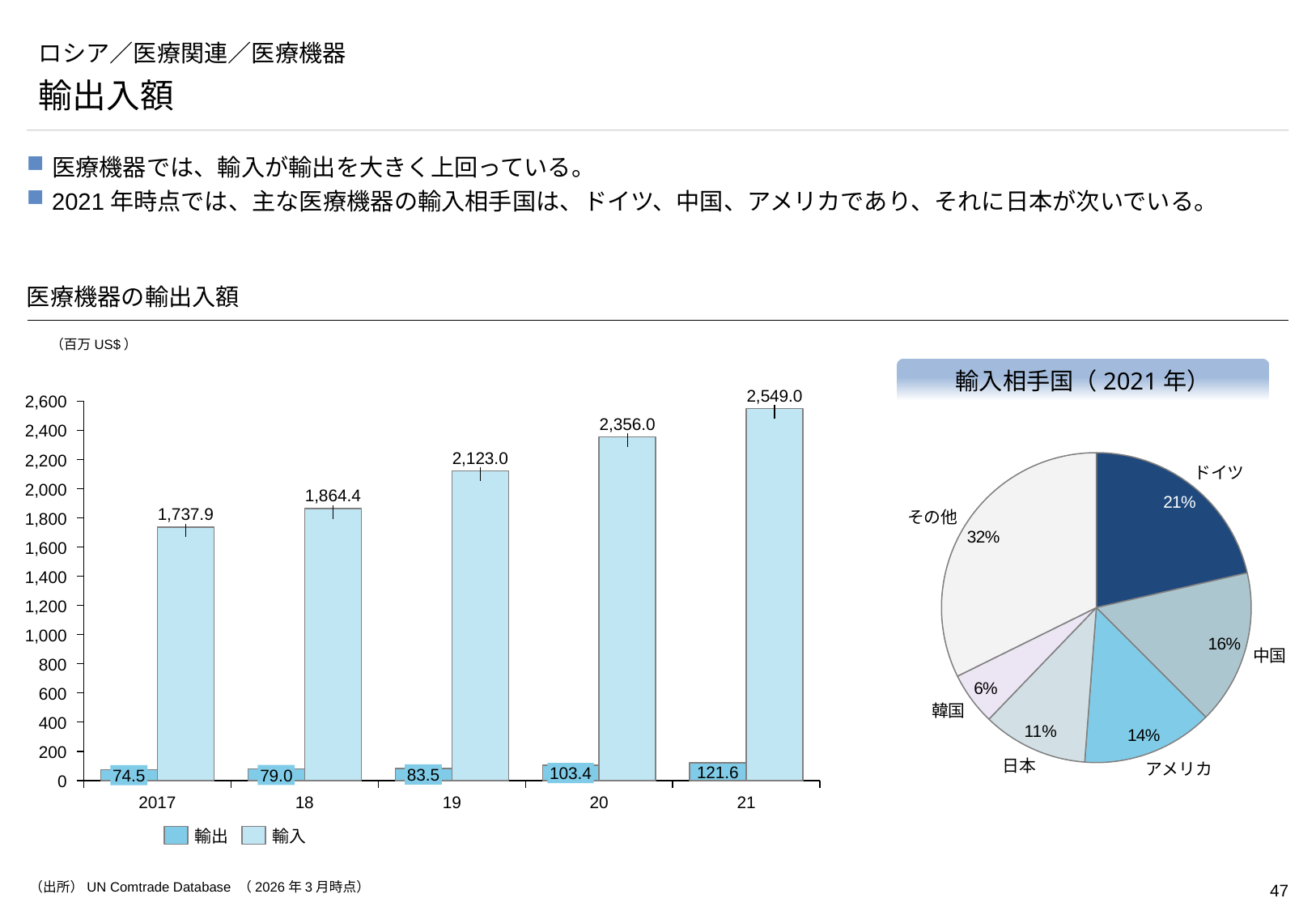
In the pie chart 輸入相手国（2021年）, which is larger, the share of 中国 or the share of アメリカ? 中国 In the bar chart 医療機器の輸出入額, how many years are shown on the x axis? 5 In the bar chart 医療機器の輸出入額, what is the 輸入 value for 2019? 2,123.0 In the pie chart 輸入相手国（2021年）, which named country has the smallest share? 韓国 In the bar chart 医療機器の輸出入額, what is the difference between the 輸入 values for 2021 and 2020? 193.0 In the bar chart 医療機器の輸出入額, which year has the lowest 輸入 value? 2017 In the bar chart 医療機器の輸出入額, does the 輸入 value rise or fall from 2017 to 2021? rise In the bar chart 医療機器の輸出入額, what is the 輸出 value for 2017? 74.5 In the pie chart 輸入相手国（2021年）, what share does ドイツ have? 21% In the bar chart 医療機器の輸出入額, which year has the highest 輸出 value? 21 In the bar chart 医療機器の輸出入額, what is the 輸入 value for 2021? 2,549.0 In the bar chart 医療機器の輸出入額, how many series does the legend list? 2